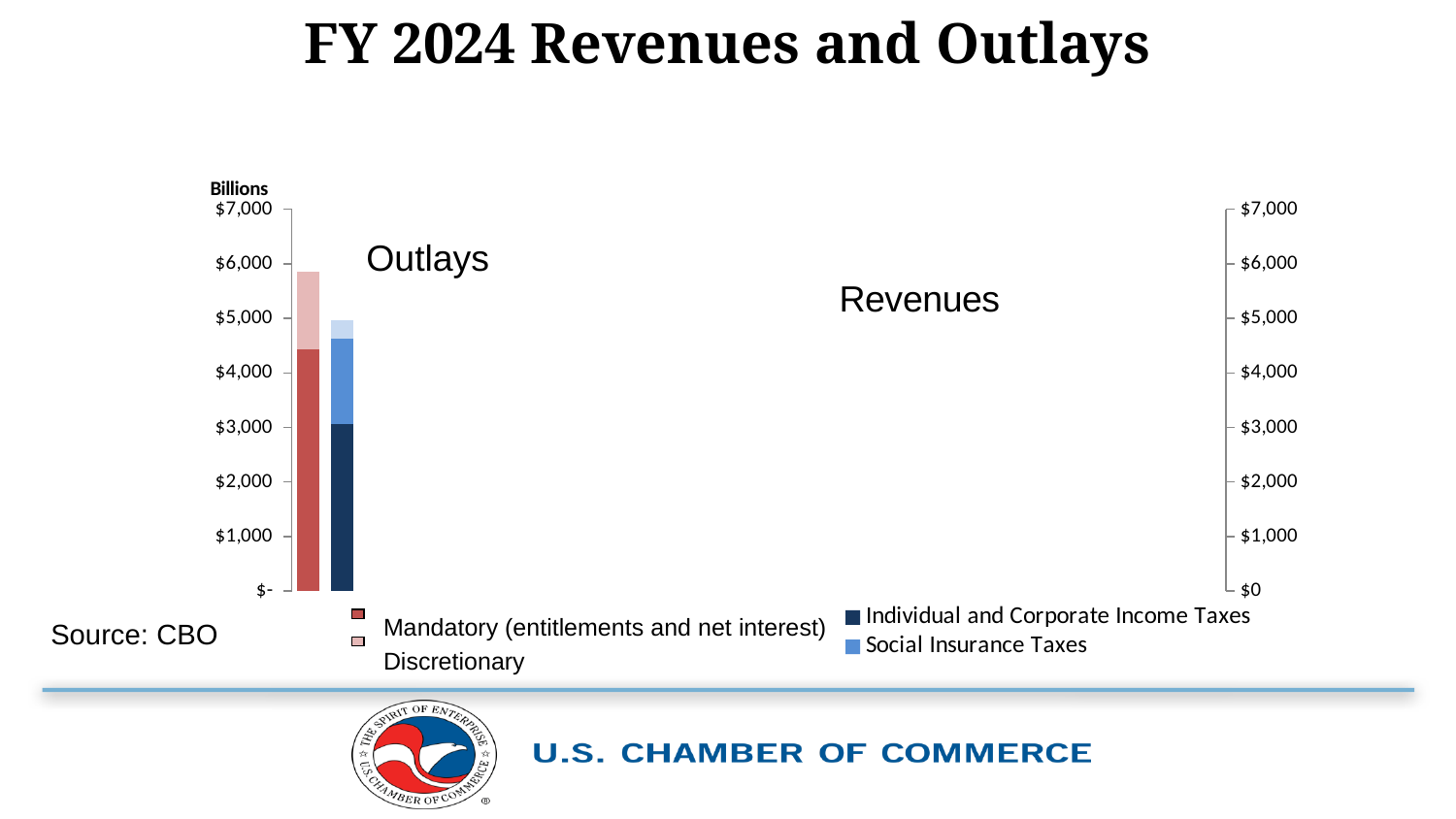
Is the Mandatory (entitlements and net interest) segment of the Outlays bar greater or less than $4,000? greater How many series does the legend list? 4 What is the title of the chart? FY 2024 Revenues and Outlays How many bars are plotted in the chart? 2 Is the total for the Revenues bar greater or less than $4,000? greater Within the Revenues bar, which segment is larger, Individual and Corporate Income Taxes or Social Insurance Taxes? Individual and Corporate Income Taxes Within the Outlays bar, which segment is larger, Mandatory (entitlements and net interest) or Discretionary? Mandatory (entitlements and net interest) What source is cited for the chart data? CBO Is the total for the Outlays bar greater or less than $5,000? greater What kind of chart is shown on the slide? Stacked bar chart Which bar is taller, Outlays or Revenues? Outlays